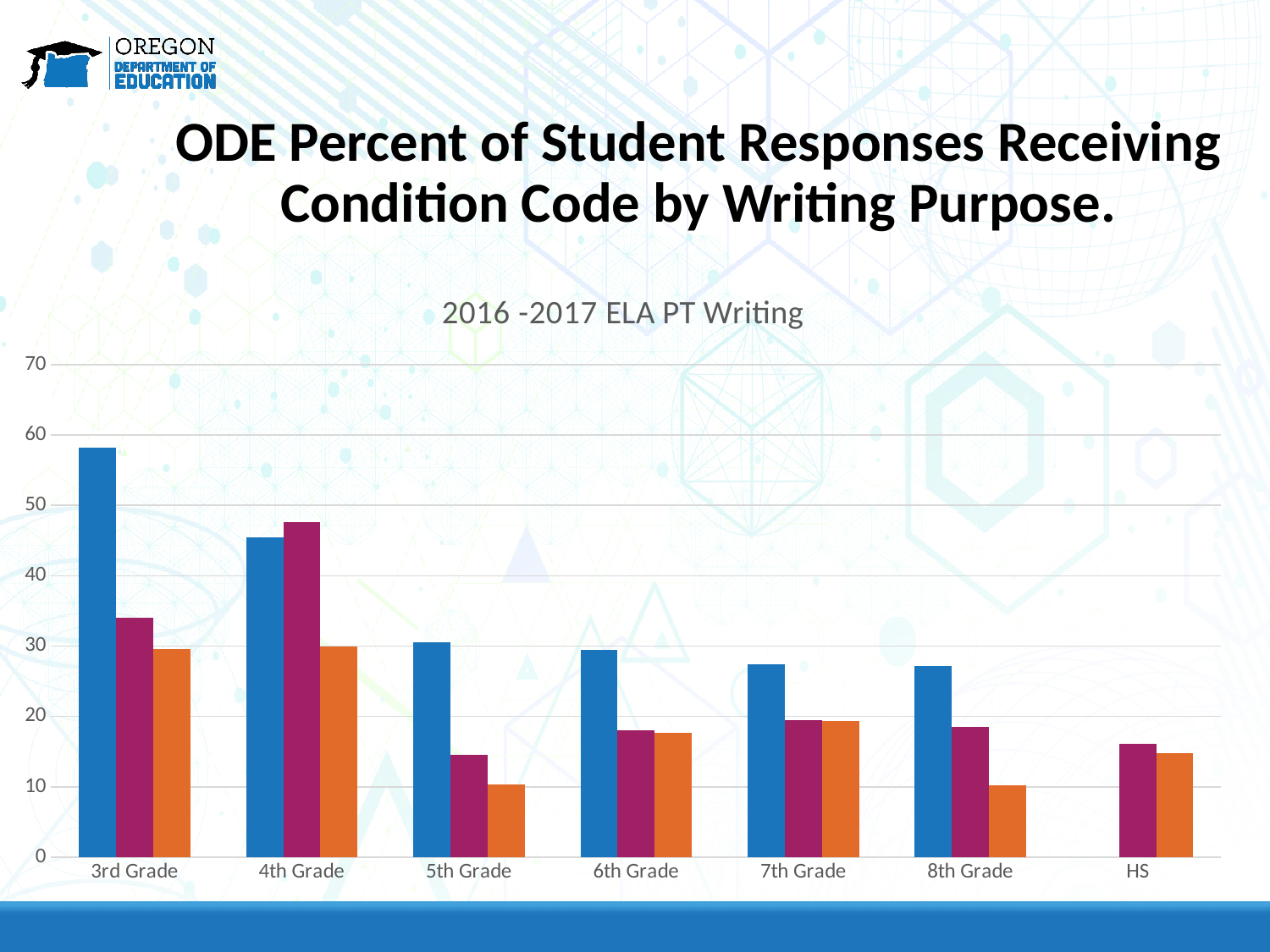
How many differently coloured bar series are plotted in the chart? 3 Is the blue bar for 7th Grade greater or less than 30? less Is the blue bar for 3rd Grade greater or less than 50? greater Do the blue bars rise or fall from 3rd Grade to 8th Grade? fall Which grade has the highest magenta bar? 4th Grade Which grade has the tallest bar in the chart? 3rd Grade What kind of chart is shown on the slide? bar chart How many grade-level categories are shown on the x axis? 7 For 3rd Grade, which is larger, the blue bar or the magenta bar? blue bar Is the orange bar for 5th Grade greater or less than 20? less What is the title printed above the chart's plot area? 2016 -2017 ELA PT Writing